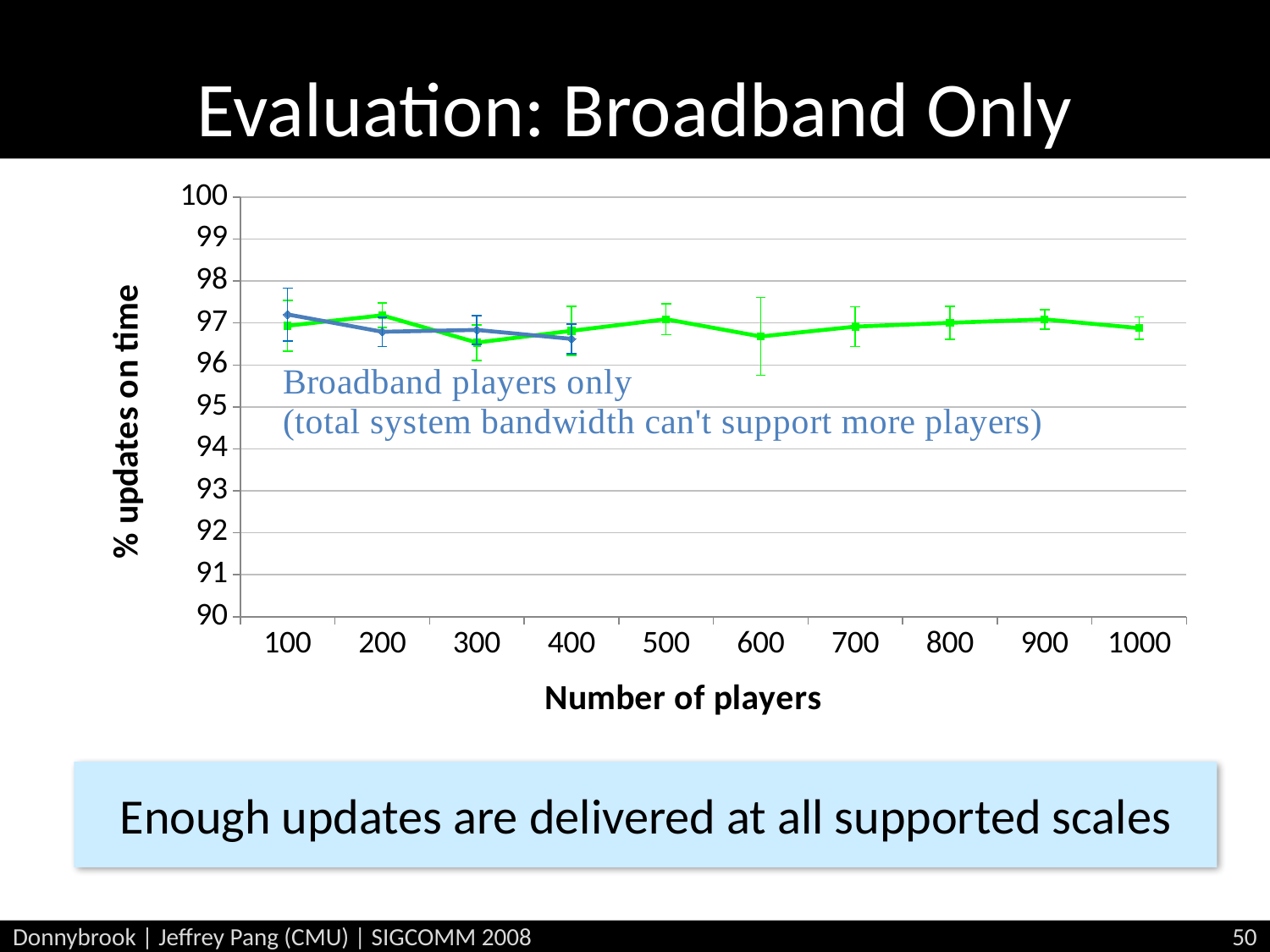
What is the label of the y axis? % updates on time Which is larger: the blue line's value at 100 players or at 400 players? 100 players Which is larger: the green line's value at 300 players or at 500 players? 500 players How many values of 'Number of players' are marked on the x axis? 10 Is the value of the green line at 300 players greater or less than 97? less Is the value of the green line at 600 players greater or less than 96? greater How many lines are plotted on the chart? 2 What is the label of the x axis? Number of players What kind of chart is shown on the slide? line chart Is the value of the blue line at 400 players greater or less than 97? less At how many player counts does the blue line have data points? 4